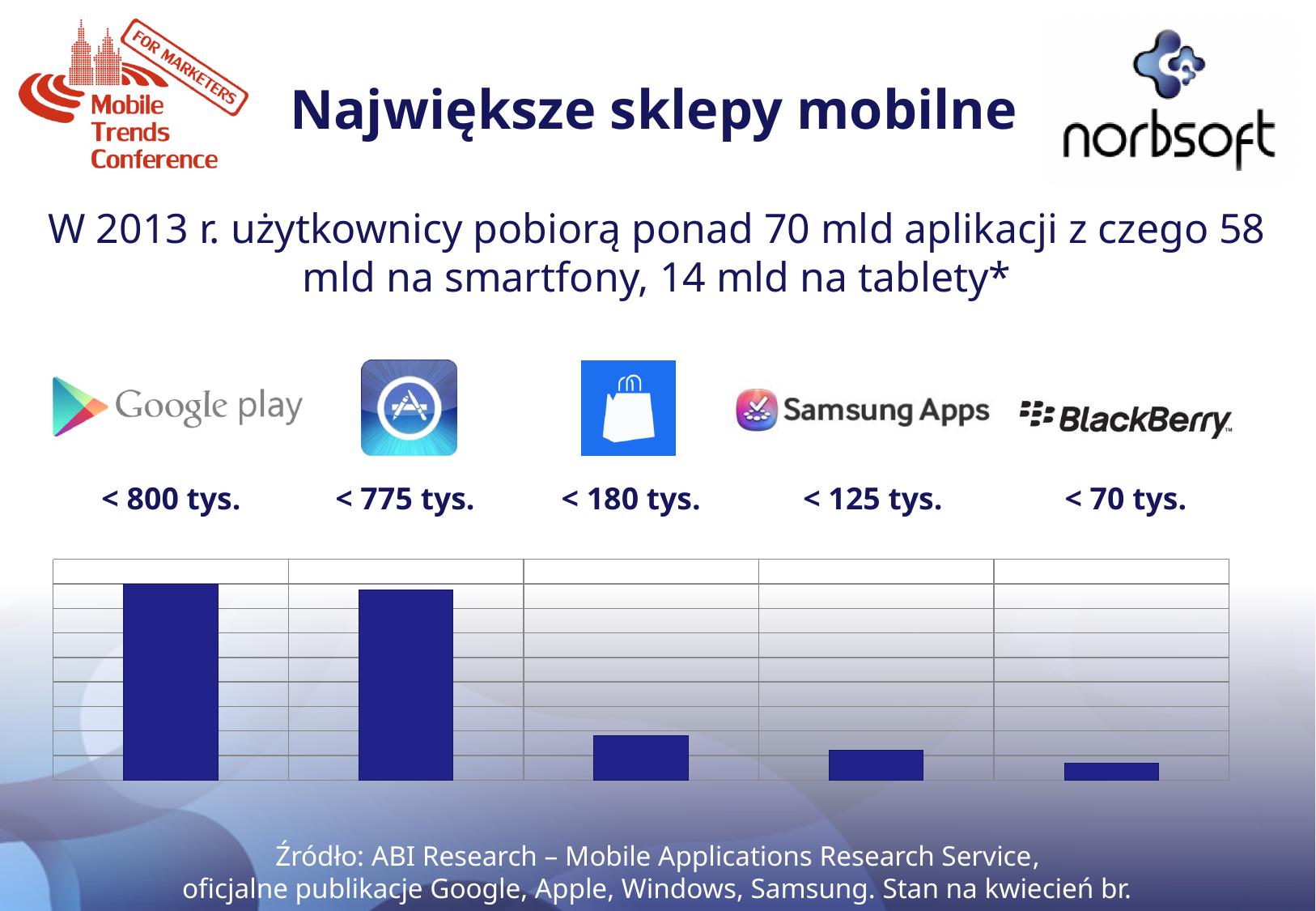
What value is printed above the middle (third) bar? < 180 tys. What value is printed above the BlackBerry bar? < 70 tys. What colour are the bars in the chart? dark blue How many bars does the chart contain? 5 What value is printed above the Samsung Apps bar? < 125 tys. What value is printed above the Google Play bar? < 800 tys. Which store has the shortest bar in the chart? BlackBerry Do the bar heights rise or fall from left to right across the chart? fall What kind of chart is shown on the slide? bar chart What is the title of the slide containing the chart? Największe sklepy mobilne Which store has the tallest bar in the chart? Google play Which bar is taller: Samsung Apps or BlackBerry? Samsung Apps